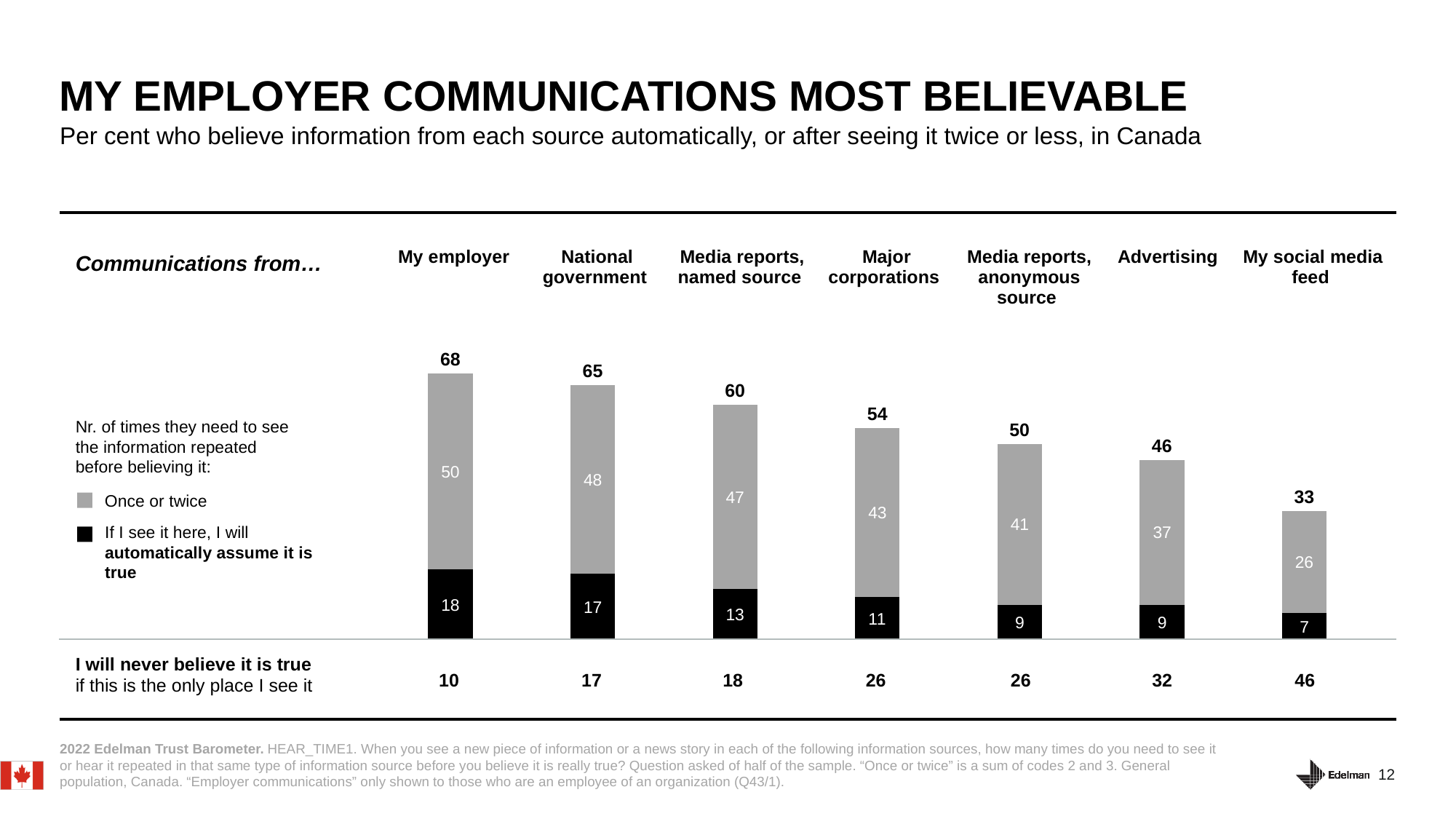
How many series does the legend list for the stacked bars? 2 Which source has the lowest total stacked bar value? My social media feed What is the 'Once or twice' value for Media reports, named source? 47 What is the 'I will never believe it is true' value for My social media feed? 46 How many sources (categories) are shown in the chart? 7 Which source has the highest 'automatically assume it is true' value? My employer What kind of chart is shown on the slide? Stacked bar chart What is the difference between the total for National government and the total for Advertising? 19 Do the total stacked bar values rise or fall from left to right across the sources? Fall What is the 'automatically assume it is true' value for Major corporations? 11 Which is larger: the 'Once or twice' value for Media reports, anonymous source or for Advertising? Media reports, anonymous source What is the total stacked bar value for My employer? 68